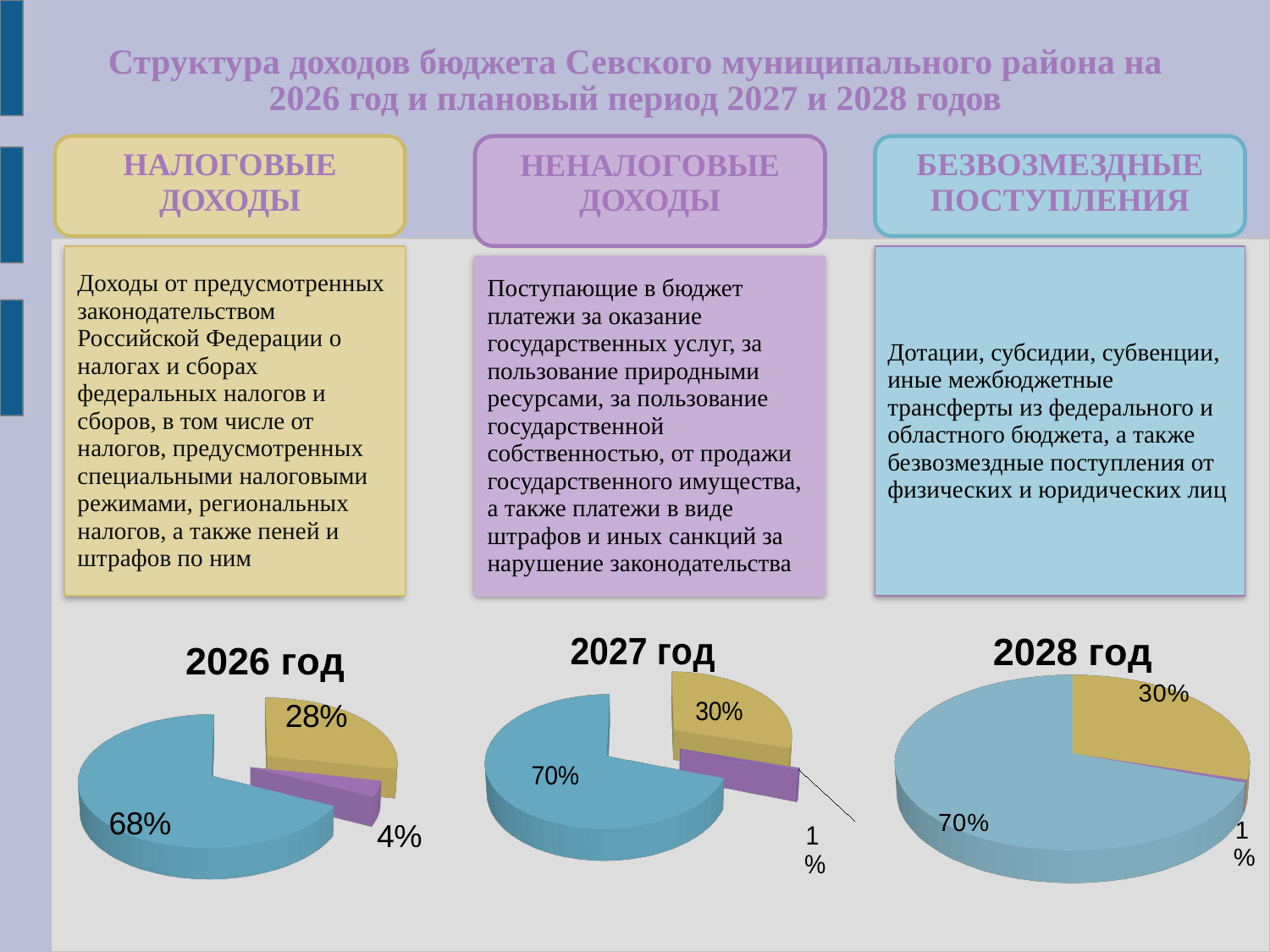
How many slices does the "2028 год" pie chart have? 3 Which is larger: the yellow slice in the "2026 год" chart or the yellow slice in the "2027 год" chart? the yellow slice in the 2027 год chart In the "2027 год" chart, what is the value of the smallest slice? 1% In the "2028 год" chart, what percentage is shown on the yellow slice? 30% In the "2026 год" chart, what percentage is shown on the purple slice? 4% In the "2026 год" chart, what percentage is shown on the yellow slice? 28% What are the titles of the three pie charts on the slide? 2026 год, 2027 год, 2028 год In the "2026 год" chart, by how many percentage points does the blue slice exceed the yellow slice? 40 percentage points What kind of chart is the "2026 год" chart? pie chart In the "2026 год" chart, what is the value of the largest slice? 68% In the "2026 год" chart, what percentage is shown on the blue slice? 68% In the "2027 год" chart, what percentage is shown on the blue slice? 70%